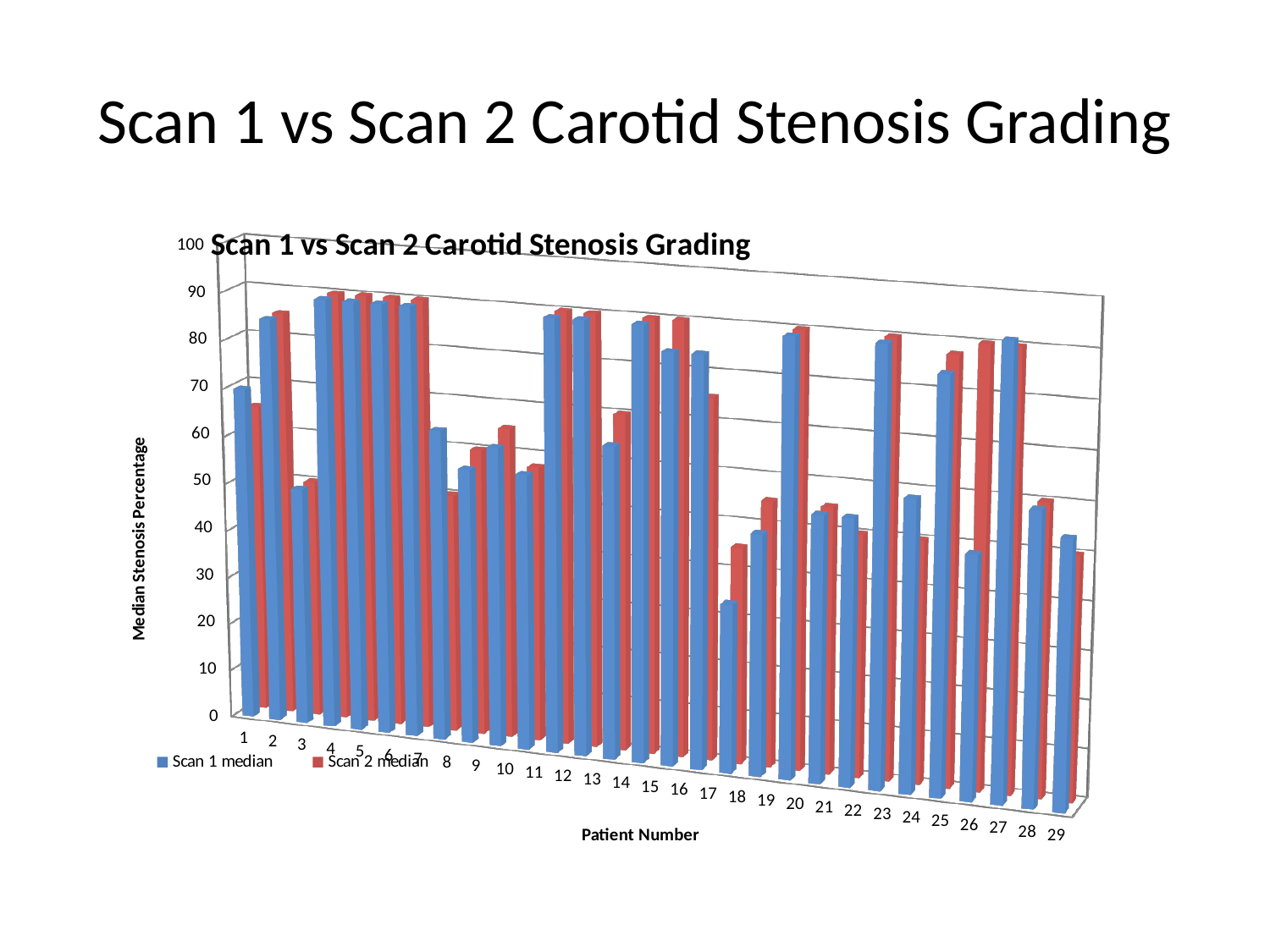
For patient 18, which is larger: the Scan 1 median or the Scan 2 median? Scan 2 median What is the label on the vertical axis of the chart? Median Stenosis Percentage Which colour represents the Scan 2 median series in the legend? red Is the Scan 2 median value for patient 26 greater or less than 70? greater Is the Scan 1 median value for patient 1 greater or less than 60? greater Which patient has the lowest Scan 1 median value? 18 For patient 26, which is larger: the Scan 1 median or the Scan 2 median? Scan 2 median How many series does the legend list? 2 How many patients are plotted along the x axis? 29 What kind of chart is shown on the slide? bar chart For patient 8, which is larger: the Scan 1 median or the Scan 2 median? Scan 1 median